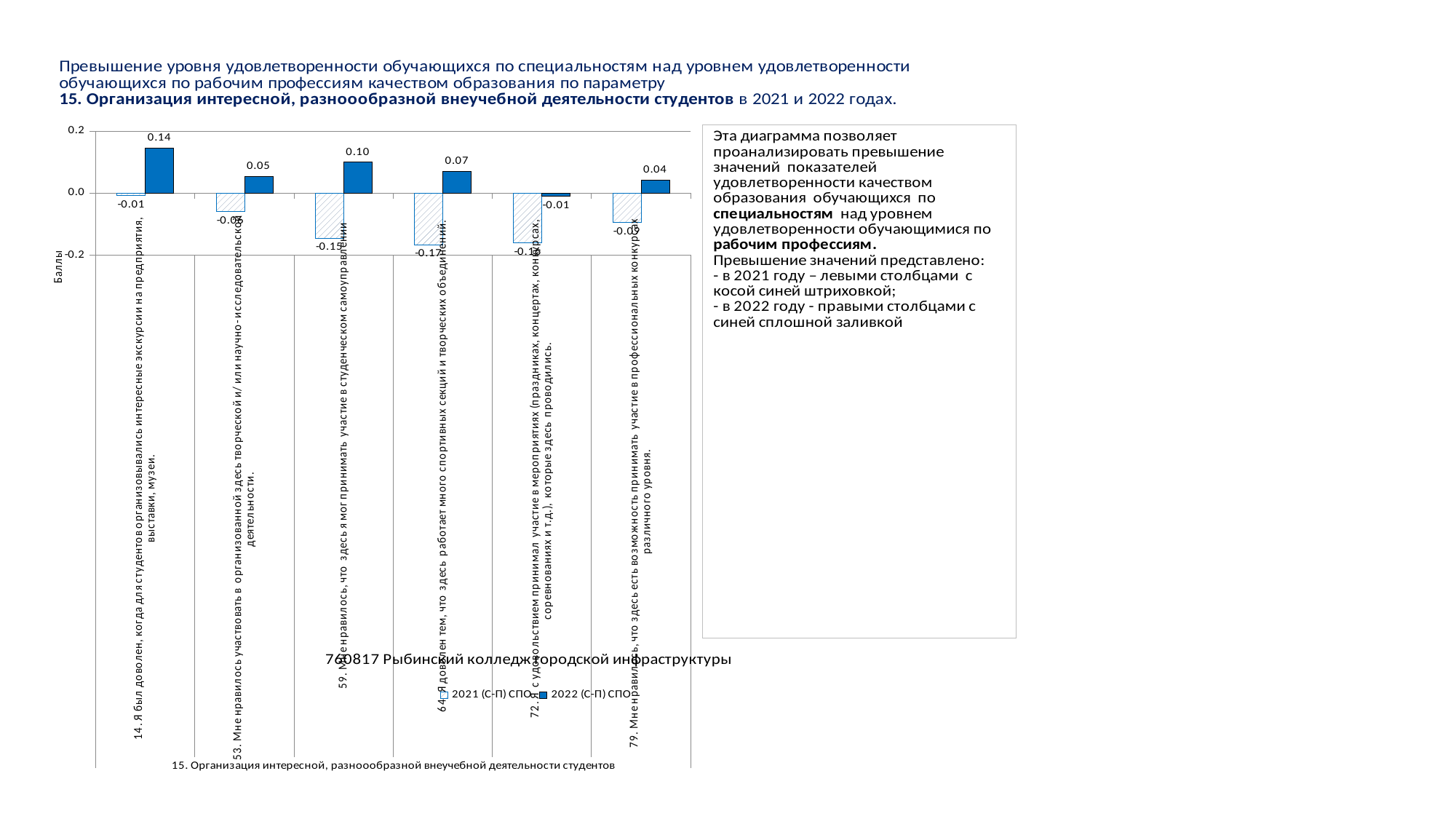
What is the 2022 (С-П) СПО value for item 14 (interesting excursions to enterprises, exhibitions, museums)? 0.14 How many items (categories) are shown on the chart? 6 What is the 2022 (С-П) СПО value for item 72 (participation in events, holidays, concerts, competitions)? -0.01 Which item has the highest 2022 (С-П) СПО value? 14 (excursions to enterprises, exhibitions, museums) Is the 2021 (С-П) СПО value for item 59 (student self-government) greater or less than 0.0? less How many series does the legend list? 2 What is the 2022 (С-П) СПО value for item 64 (many sports sections and creative associations)? 0.07 What kind of chart is shown on the slide? Bar chart Which item has the lowest 2022 (С-П) СПО value? 72 (participation in events, holidays, concerts, competitions) Which has the larger 2022 (С-П) СПО value: item 59 (student self-government) or item 64 (sports sections and creative associations)? Item 59 What is the 2021 (С-П) СПО value for item 64 (many sports sections and creative associations)? -0.17 What is the difference between the 2022 (С-П) СПО values for item 14 and item 53? 0.09